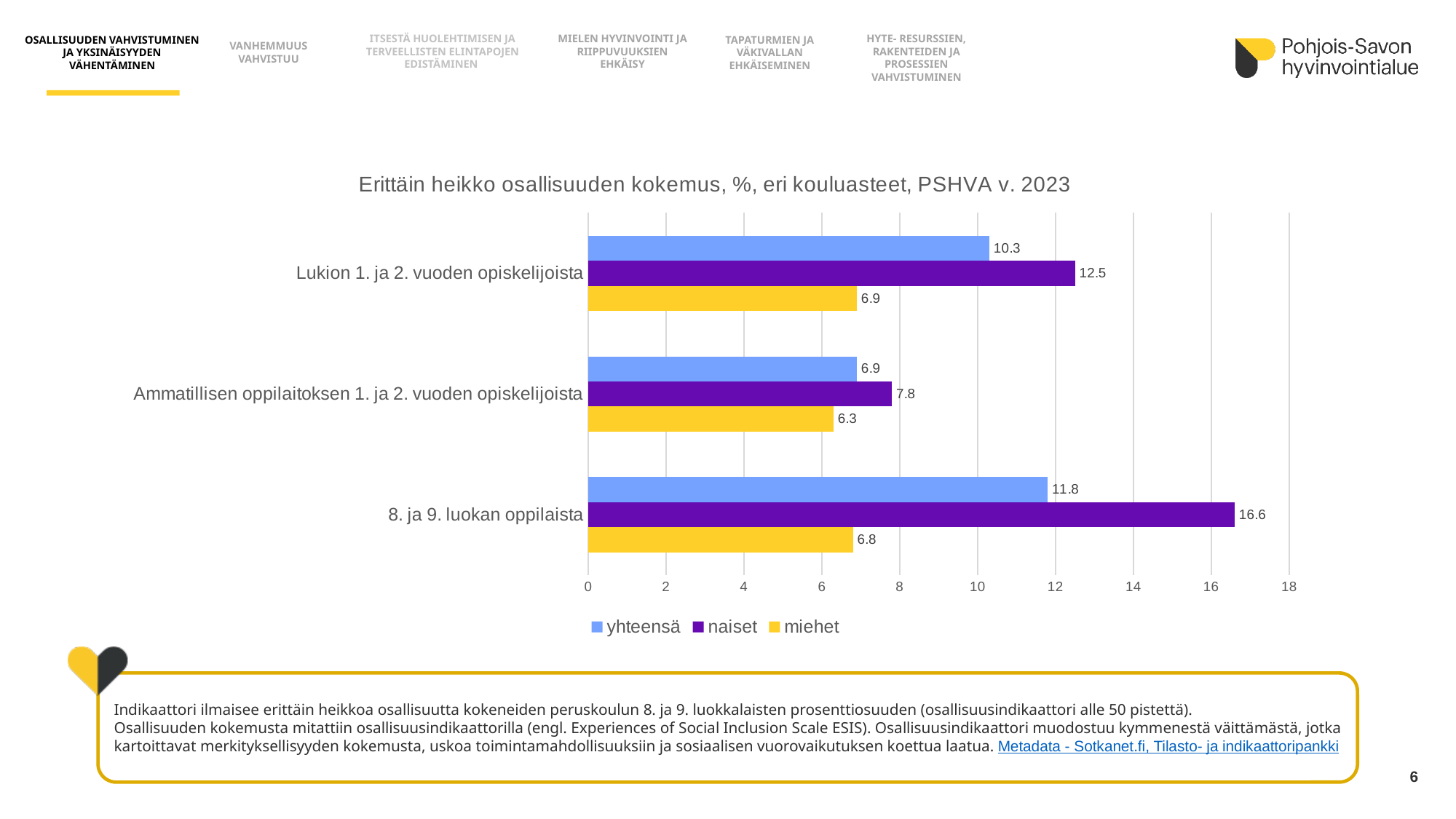
What is the title of the chart? Erittäin heikko osallisuuden kokemus, %, eri kouluasteet, PSHVA v. 2023 How many categories are shown on the y axis? 3 Is the value for naiset among Lukion 1. ja 2. vuoden opiskelijoista greater or less than 10? greater Which category has the highest value for naiset? 8. ja 9. luokan oppilaista What is the difference between the naiset and miehet values for 8. ja 9. luokan oppilaista? 9.8 Which is larger for Lukion 1. ja 2. vuoden opiskelijoista: the naiset value or the yhteensä value? naiset Which category has the lowest value for yhteensä? Ammatillisen oppilaitoksen 1. ja 2. vuoden opiskelijoista How many series does the legend list? 3 What is the value for naiset among 8. ja 9. luokan oppilaista? 16.6 What is the value for miehet among Ammatillisen oppilaitoksen 1. ja 2. vuoden opiskelijoista? 6.3 What kind of chart is shown on the slide? Bar chart What is the value for yhteensä among Lukion 1. ja 2. vuoden opiskelijoista? 10.3